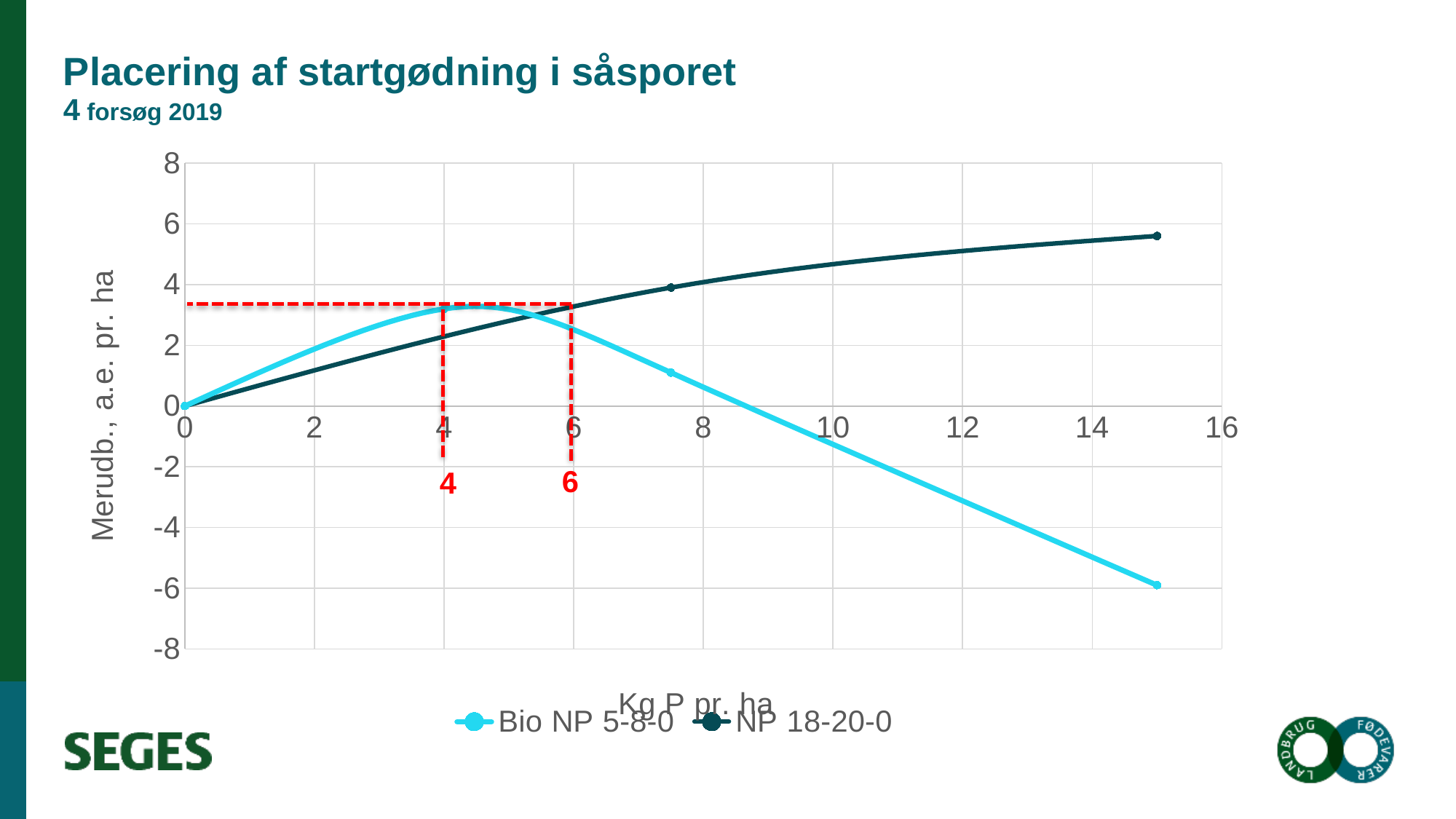
What two x-axis values are marked by the red dashed lines and red labels? 4 and 6 How many series does the legend list? 2 Is the value for NP 18-20-0 at 15 kg P pr. ha greater or less than 6? less Does the Bio NP 5-8-0 line rise or fall between 7.5 and 15 kg P pr. ha? fall What is the title of the x axis? Kg P pr. ha What kind of chart is shown on the slide? line chart Is the value for NP 18-20-0 at 15 kg P pr. ha greater or less than 4? greater What are the two series named in the legend? Bio NP 5-8-0 and NP 18-20-0 Is the value for Bio NP 5-8-0 at 15 kg P pr. ha greater or less than -8? greater At 15 kg P pr. ha, which series has the higher value, Bio NP 5-8-0 or NP 18-20-0? NP 18-20-0 Does the NP 18-20-0 line rise or fall as kg P pr. ha increases? rise